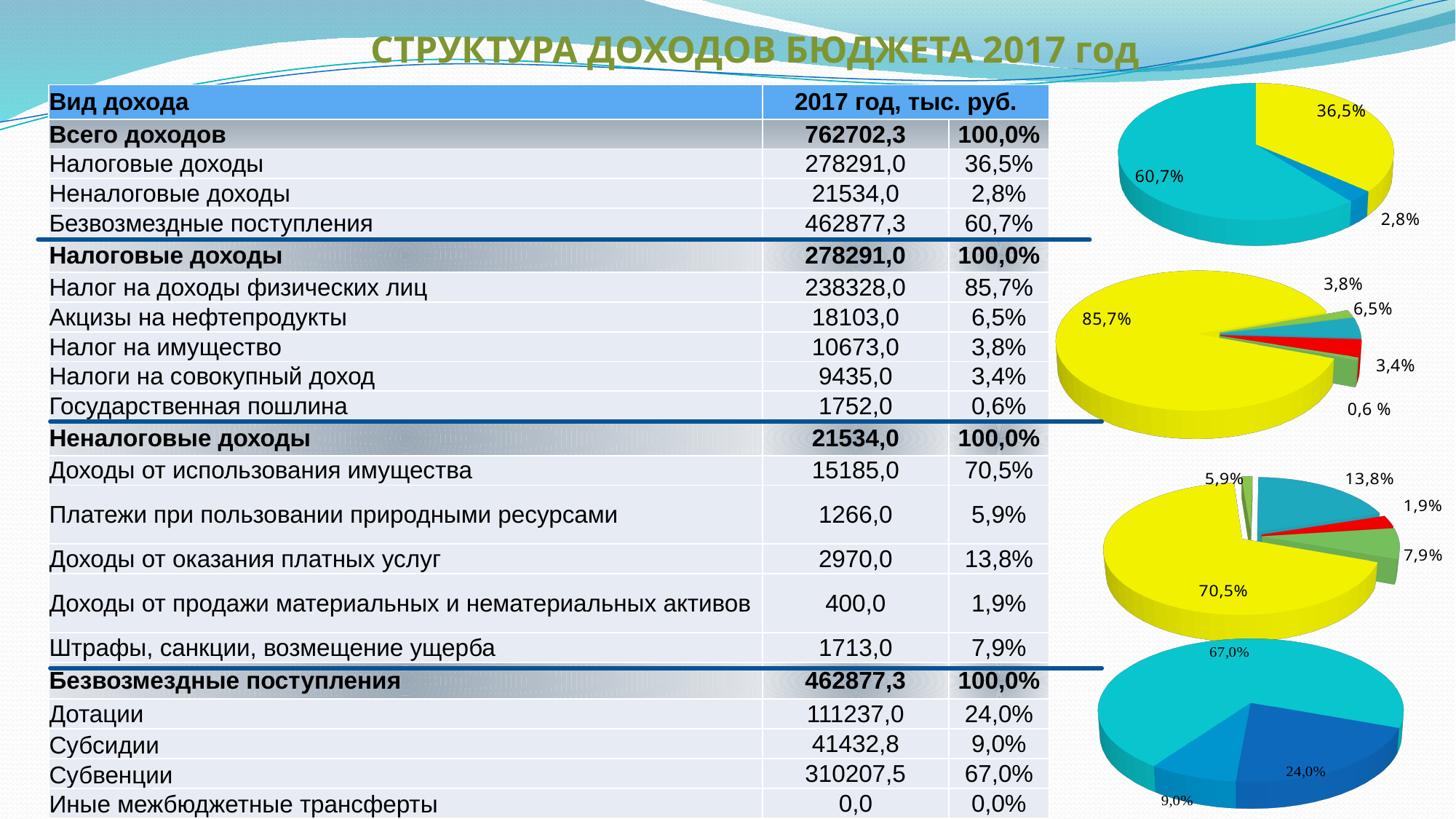
In the second pie chart from the top, what is the share of the smallest slice? 0,6 % In the top pie chart, how many slices are labelled? 3 In the third pie chart from the top, what is the difference between the 13,8% slice and the 7,9% slice? 5,9% In the top pie chart, what share is labelled for the slice corresponding to Налоговые доходы in the table? 36,5% In the second pie chart from the top, what is the share of the largest slice? 85,7% How many pie charts are shown on the right side of the slide? 4 In the second pie chart from the top, how many slices are labelled? 5 In the bottom pie chart, which is larger: the slice labelled 24,0% or the slice labelled 9,0%? 24,0% What kind of chart is the top chart on the right side of the slide? pie chart In the top pie chart, what is the share of the largest slice? 60,7% In the top pie chart, what is the share of the smallest slice? 2,8% In the bottom pie chart, what is the share of the largest slice? 67,0%